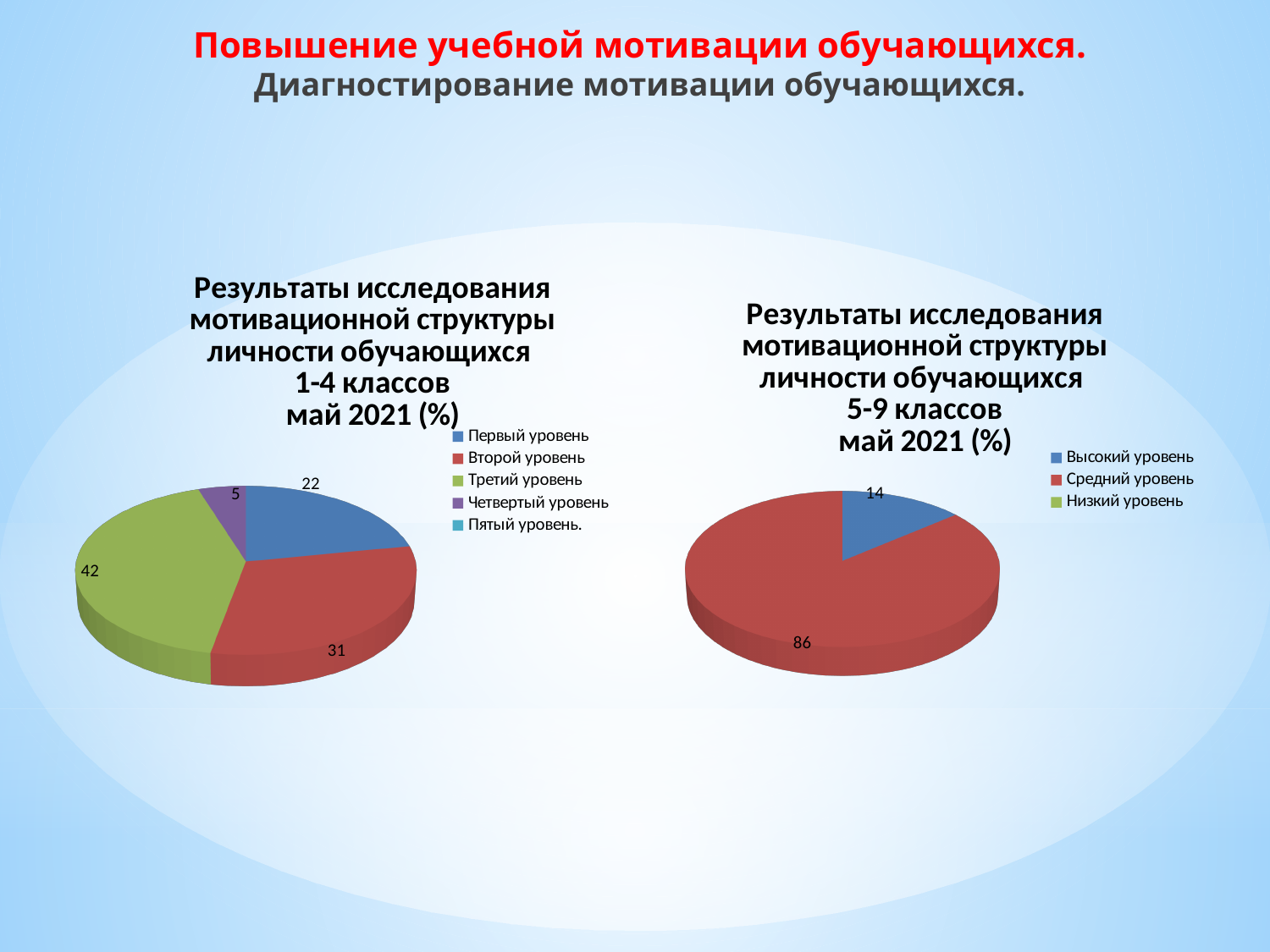
In the right chart (5-9 классов), what is the difference between Средний уровень and Высокий уровень? 72 How many entries does the legend of the right chart (5-9 классов) list? 3 In the left chart (1-4 классов), what is the difference between Третий уровень and Второй уровень? 11 In the left chart (1-4 классов), which labelled level has the smallest slice? Четвертый уровень What kind of chart is the left chart (1-4 классов)? Pie chart In the left chart (1-4 классов), what is the value for Третий уровень? 42 In the left chart (1-4 классов), what is the value for Четвертый уровень? 5 In the left chart (1-4 классов), what is the value for Первый уровень? 22 In the left chart (1-4 классов), which is larger: Второй уровень or Первый уровень? Второй уровень In the right chart (5-9 классов), what is the value for Средний уровень? 86 In the left chart (1-4 классов), which level has the largest slice? Третий уровень In the right chart (5-9 классов), what is the value for Высокий уровень? 14